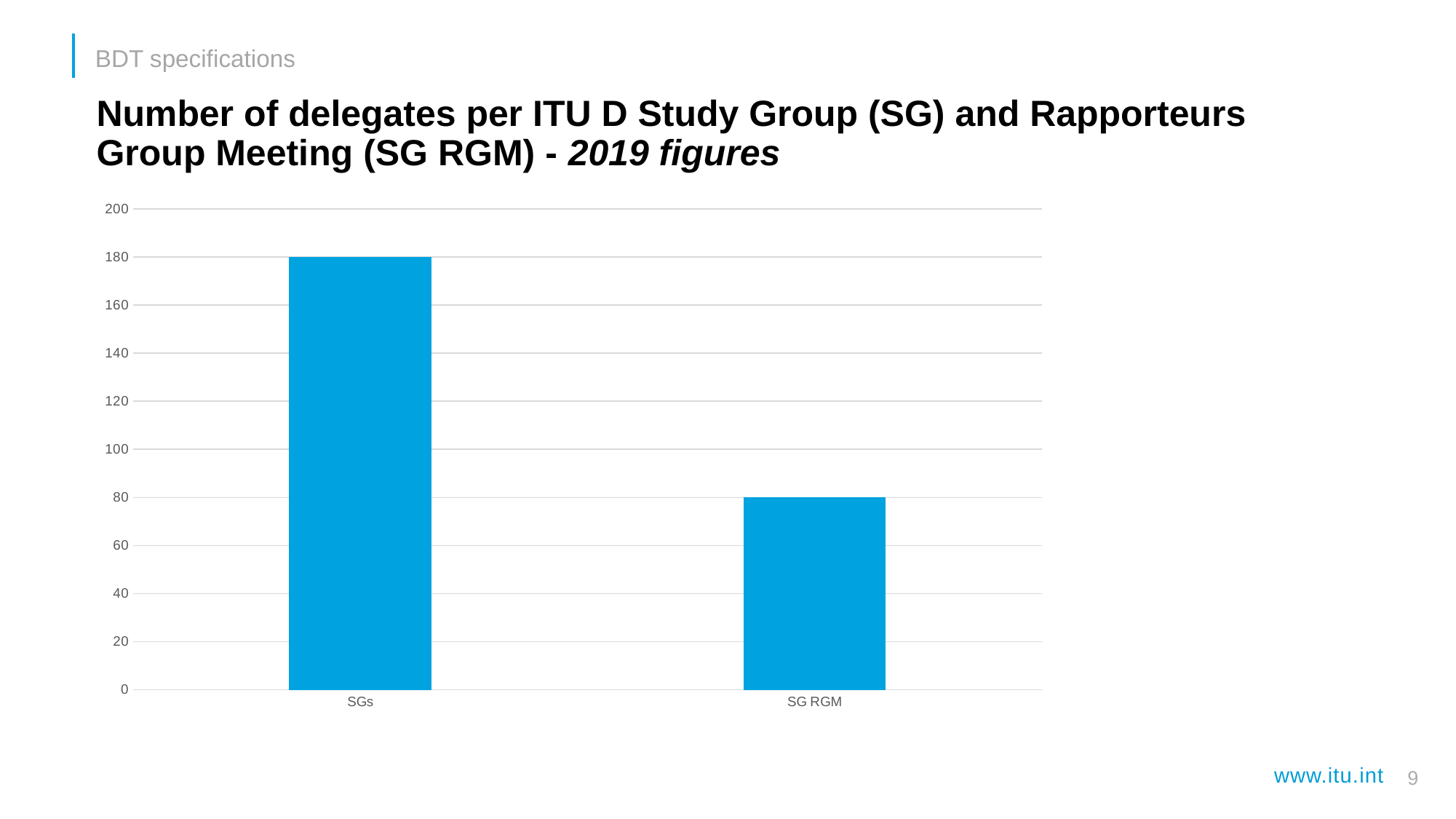
What is the number of delegates for SGs? 180 What kind of chart is shown on the slide? bar chart Which year do the figures in the chart refer to? 2019 What is the highest value shown on the y axis? 200 What is the difference between the number of delegates for SGs and for SG RGM? 100 Which has more delegates, SGs or SG RGM? SGs Is the value for SGs greater or less than 160? greater Which category has the highest number of delegates? SGs What is the number of delegates for SG RGM? 80 How many categories are shown on the x axis? 2 Is the value for SG RGM greater or less than 100? less Which category has the lowest number of delegates? SG RGM